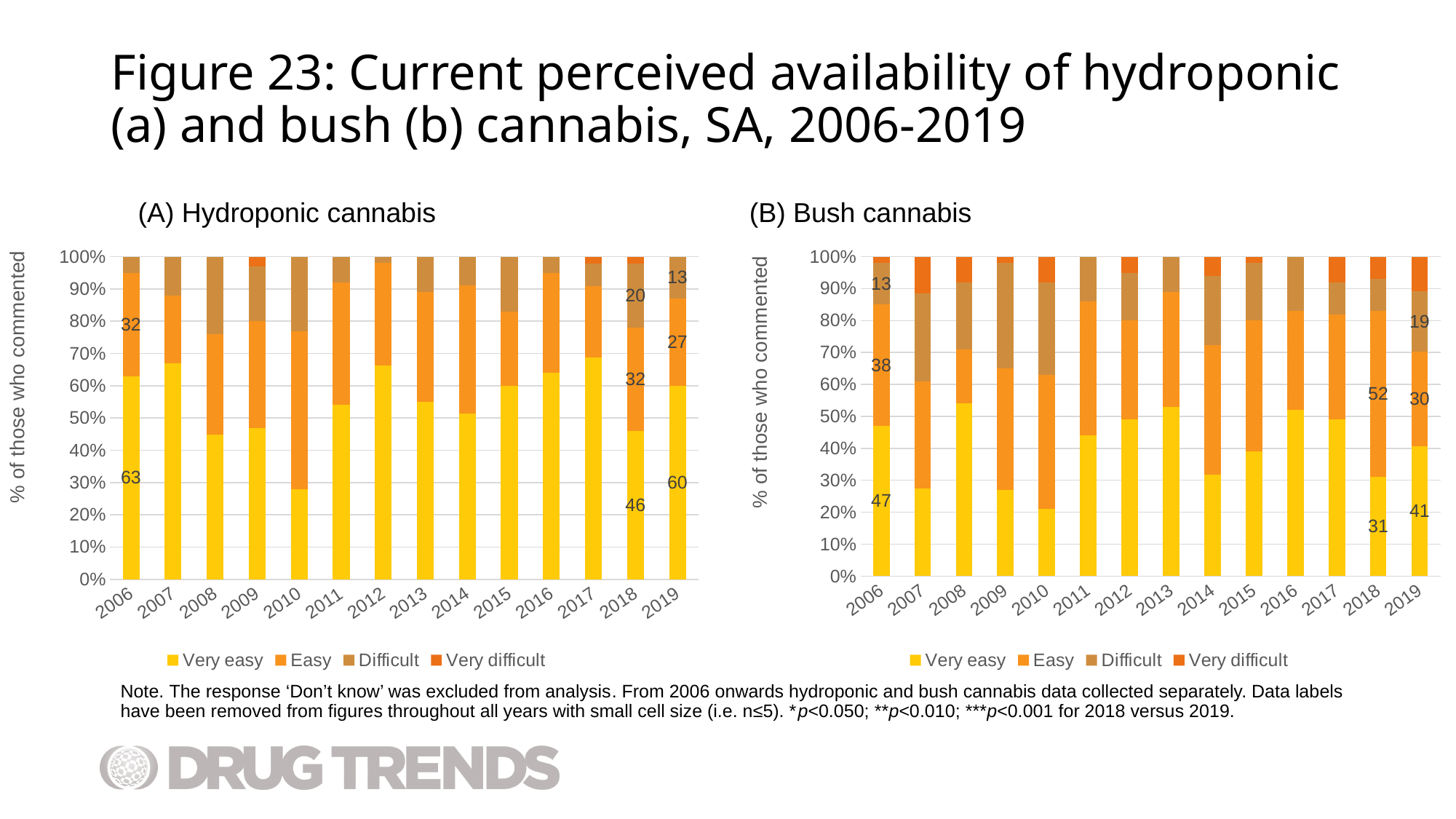
How many years are shown on the x axis of the (B) Bush cannabis chart? 14 In the (A) Hydroponic cannabis chart, what is the data label for 'Very easy' in 2006? 63 In the (A) Hydroponic cannabis chart, by how much did the 'Very easy' value increase from 2018 to 2019? 14 In the (A) Hydroponic cannabis chart, what is the data label for 'Difficult' in 2019? 13 In the (A) Hydroponic cannabis chart, is the 'Very easy' value for 2007 greater or less than 60%? greater In the (B) Bush cannabis chart, what is the difference between the 'Easy' values for 2018 and 2019? 22 In the (B) Bush cannabis chart, what is the data label for 'Very easy' in 2019? 41 What is the y-axis label of the (A) Hydroponic cannabis chart? % of those who commented How many series does the legend of the (A) Hydroponic cannabis chart list? 4 In the (B) Bush cannabis chart, what is the data label for 'Easy' in 2018? 52 What kind of chart is the (B) Bush cannabis chart? Stacked bar chart In the (A) Hydroponic cannabis chart, which year has the larger 'Very easy' value, 2006 or 2018? 2006